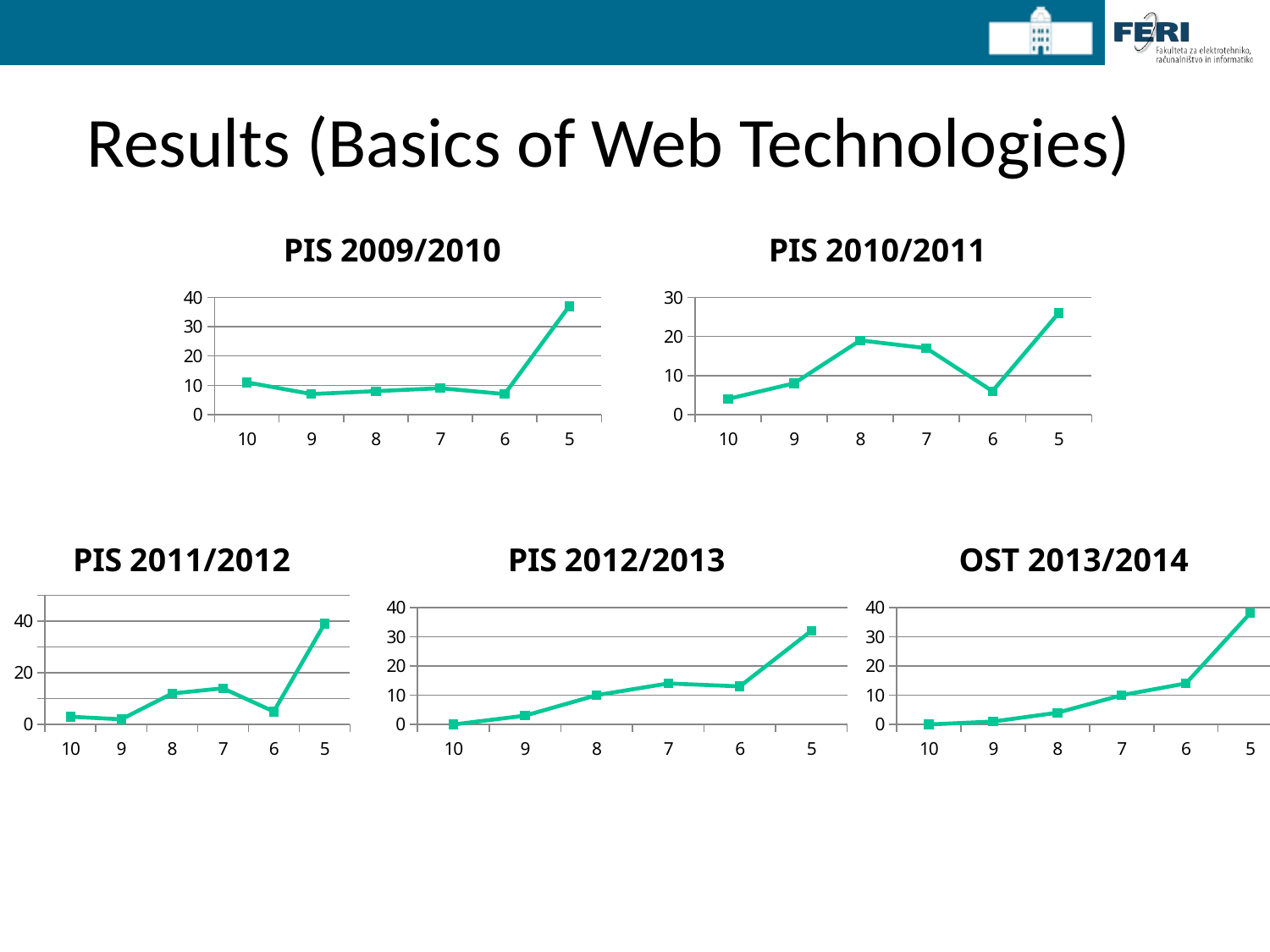
In the OST 2013/2014 chart, is the value for category 5 greater or less than 30? greater In the PIS 2009/2010 chart, how many data points are plotted? 6 In the PIS 2011/2012 chart, is the value for category 5 greater or less than 20? greater In the OST 2013/2014 chart, do the values generally rise or fall from left to right along the x axis? rise In the PIS 2010/2011 chart, which is larger, the value for category 8 or the value for category 6? 8 In the PIS 2010/2011 chart, which category has the highest value? 5 What kind of chart is the PIS 2009/2010 chart? line chart In the PIS 2010/2011 chart, is the value for category 8 greater or less than 10? greater In the PIS 2009/2010 chart, which category has the highest value? 5 In the PIS 2012/2013 chart, which category has the lowest value? 10 How many charts are shown on the slide? 5